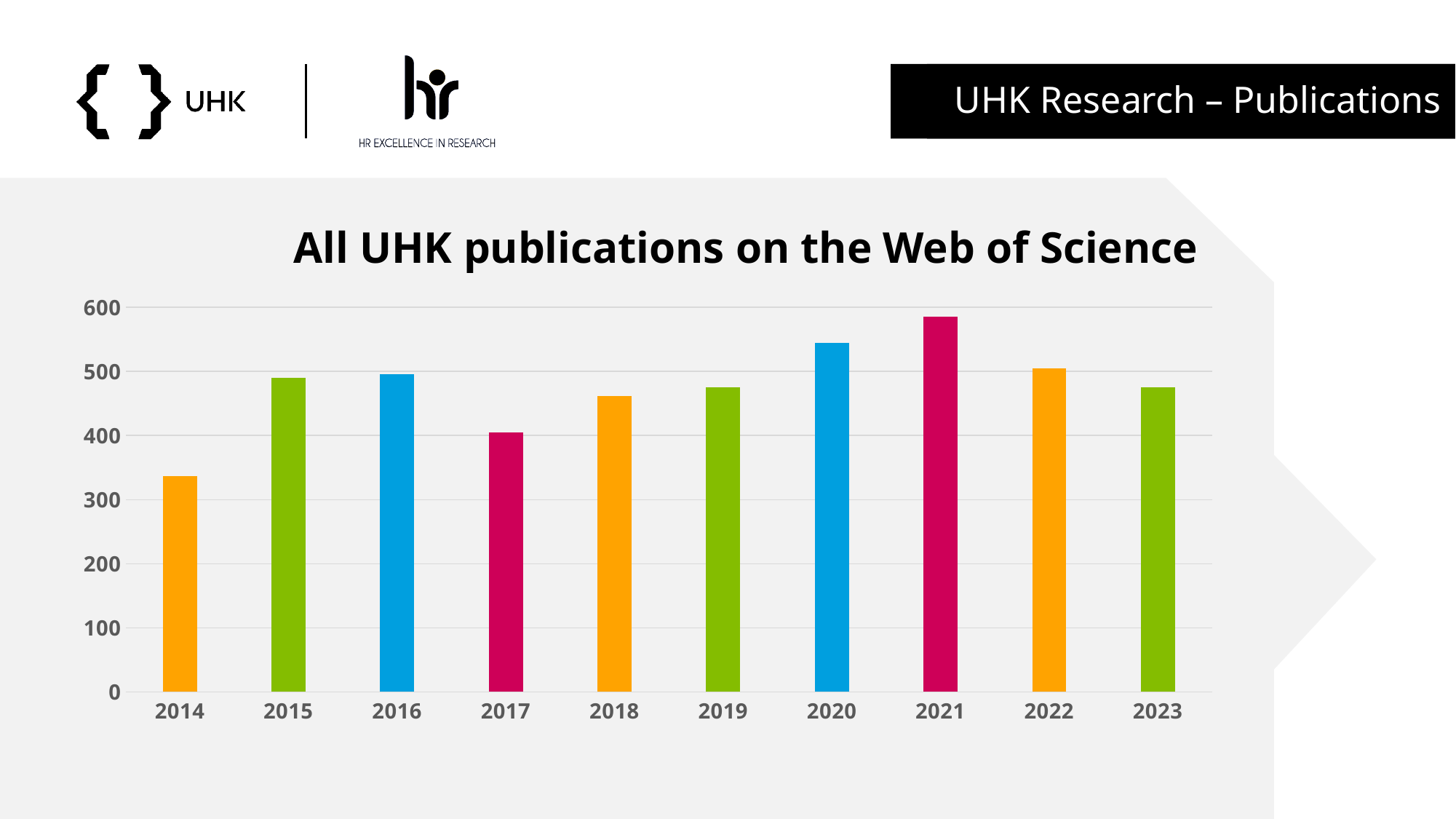
Which year has more publications, 2020 or 2017? 2020 Which year has the highest number of publications? 2021 What type of chart is shown on the slide? bar chart Is the value for 2014 greater or less than 300? greater Do the values rise or fall from 2014 to 2016? rise How many years are shown on the x axis of the chart? 10 Which year has the lowest number of publications? 2014 Is the value for 2021 greater or less than 600? less Is the value for 2017 greater or less than 500? less What is the title of the chart? All UHK publications on the Web of Science Which year has more publications, 2022 or 2018? 2022